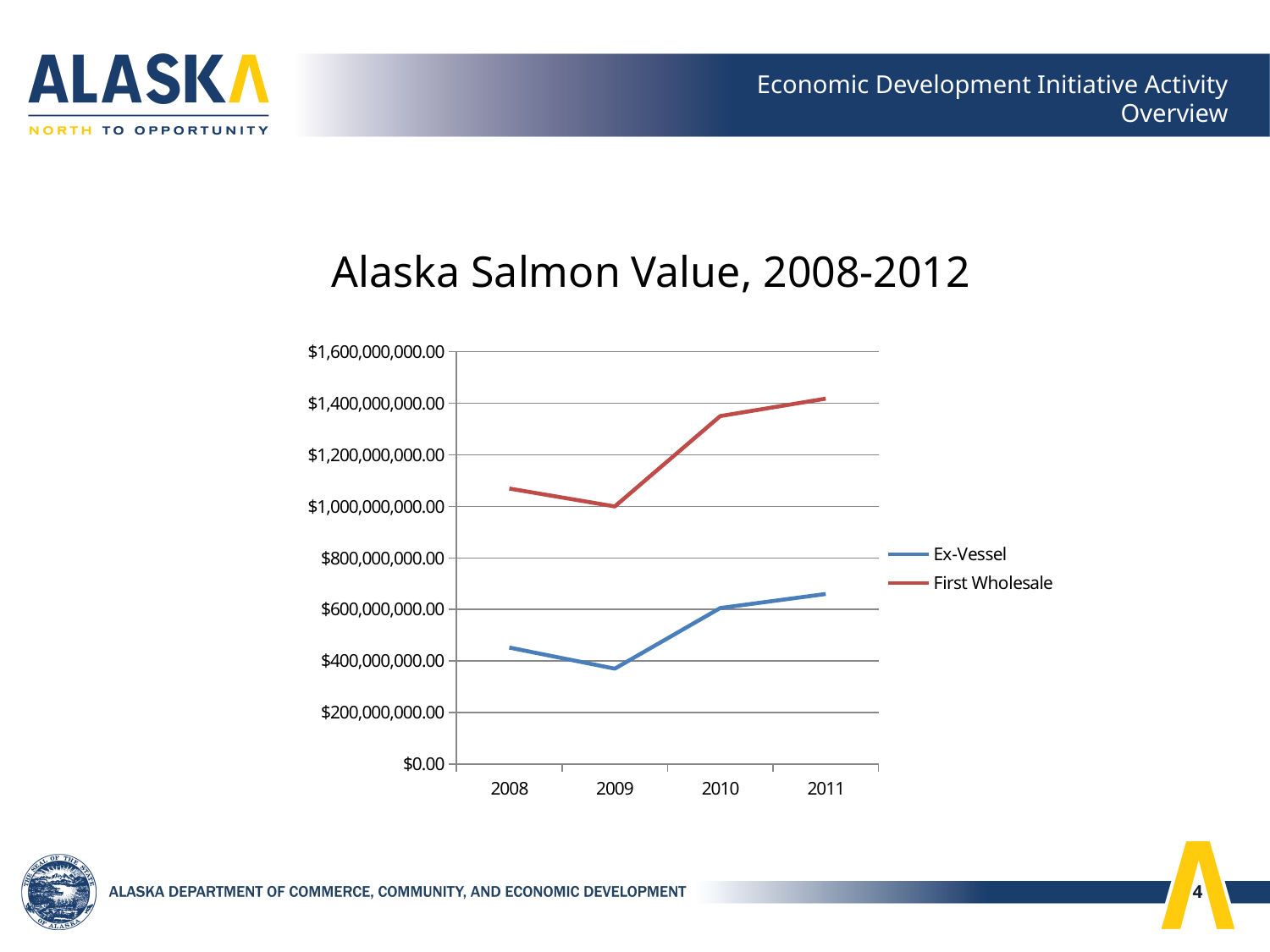
In which year is the First Wholesale value highest? 2011 Which series is drawn in red? First Wholesale Does the First Wholesale value rise or fall from 2009 to 2011? Rise What kind of chart is shown on the slide? Line chart Is the First Wholesale value for 2010 greater or less than $1,200,000,000.00? greater Is the Ex-Vessel value for 2009 greater or less than $400,000,000.00? less How many years are plotted along the x axis? 4 Is the Ex-Vessel value for 2011 greater or less than $600,000,000.00? greater How many series does the legend list? 2 What is the title of the chart? Alaska Salmon Value, 2008-2012 In which year is the Ex-Vessel value lowest? 2009 Which series has the larger value in 2010, Ex-Vessel or First Wholesale? First Wholesale